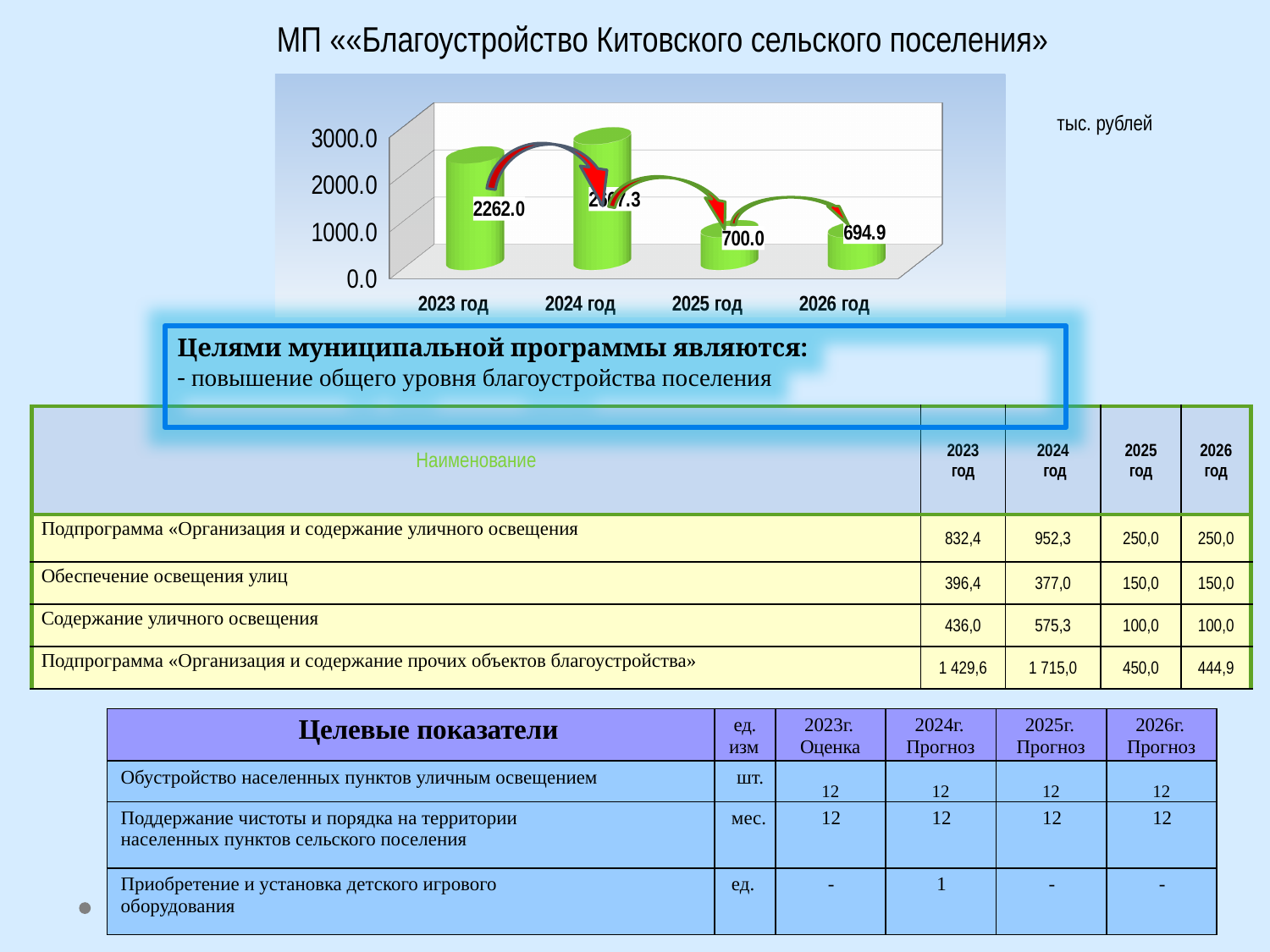
What is the value for 2026 год in the chart? 694.9 What is the difference between the values for 2023 год and 2025 год? 1562.0 Which is larger, the value for 2023 год or the value for 2025 год? 2023 год Which year has the highest value in the chart? 2024 год How many years are shown on the x axis of the chart? 4 What kind of chart is shown on the slide? bar chart From 2024 год to 2026 год, do the values rise or fall? fall Is the value for 2024 год greater or less than 2000.0? greater What is the value for 2023 год in the chart? 2262.0 Which year has the lowest value in the chart? 2026 год What is the value for 2025 год in the chart? 700.0 What is the difference between the values for 2025 год and 2026 год? 5.1